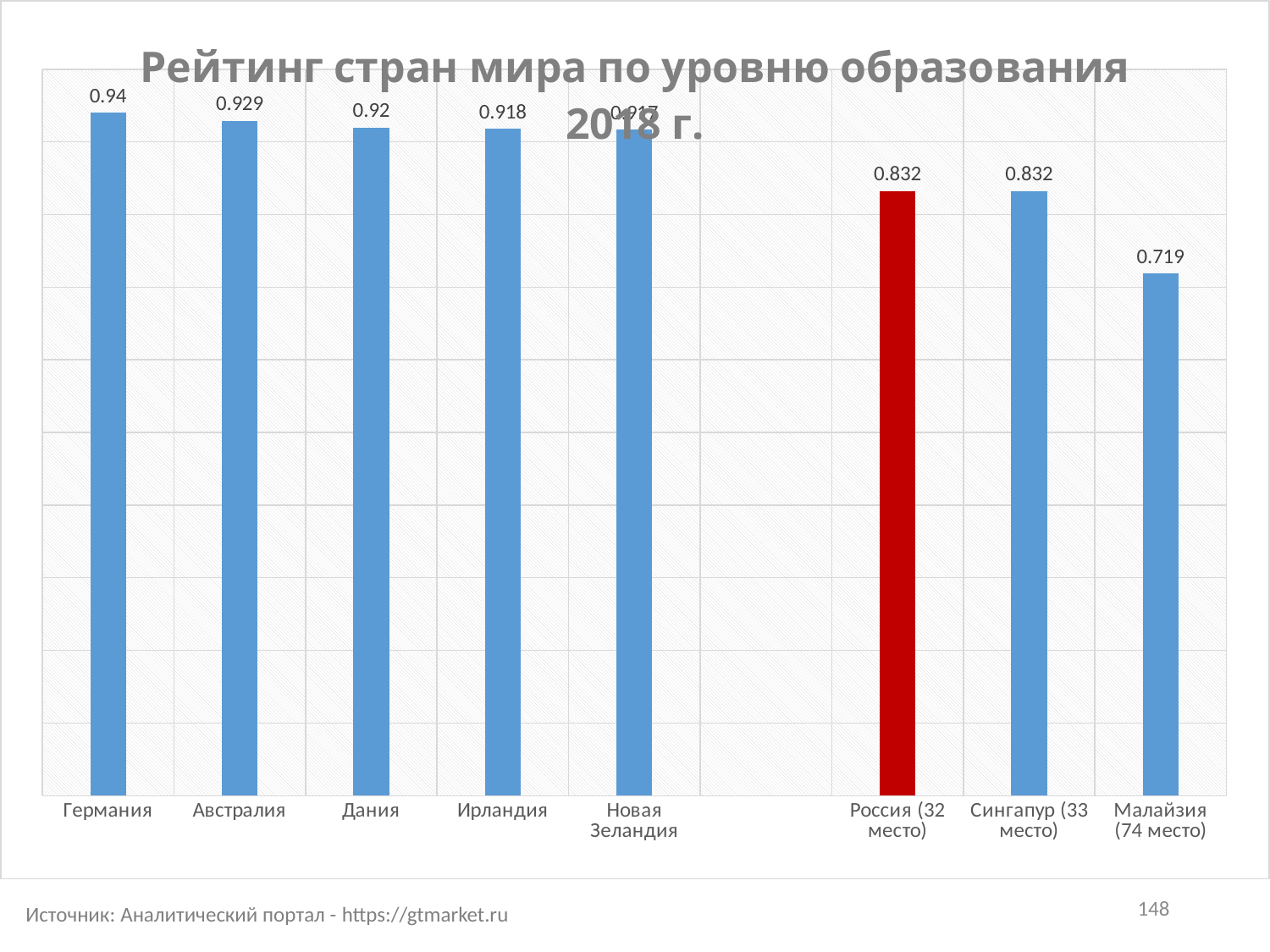
Which is larger, the value for Дания or the value for Сингапур (33 место)? Дания How many countries have bars in the chart? 8 What is the difference between the values for Германия and Малайзия (74 место)? 0.221 What is the value for Малайзия (74 место)? 0.719 What is the value for Австралия? 0.929 What is the value for Россия (32 место)? 0.832 What is the difference between the values for Германия and Россия (32 место)? 0.108 Which country has the highest value? Германия Which country has the lowest value? Малайзия (74 место) Which country's bar is coloured red instead of blue? Россия (32 место) What is the value for Германия? 0.94 What type of chart is shown on the slide? Bar chart